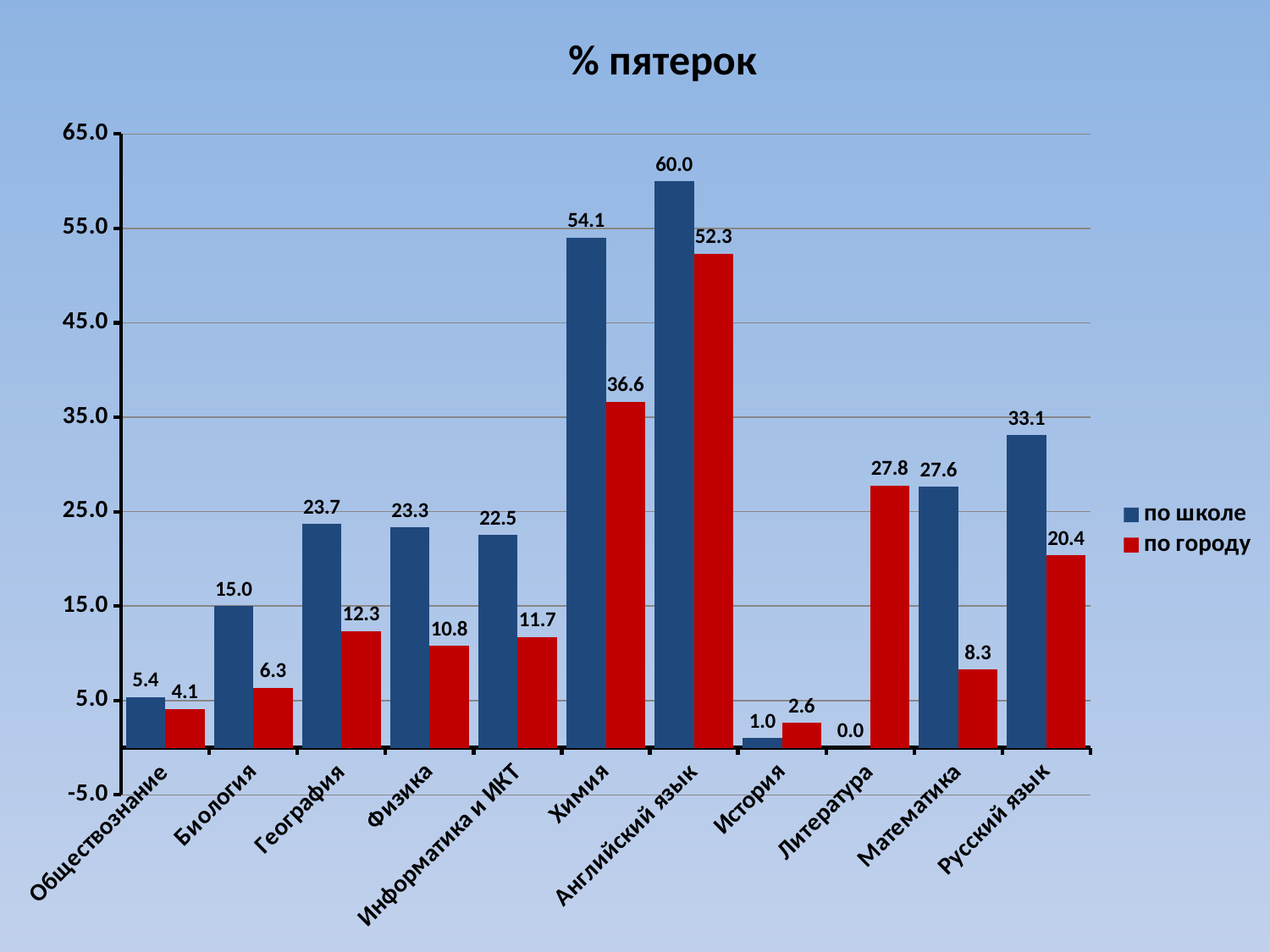
Which category has the lowest value for "по школе"? Литература What is the value for "по городу" for Математика? 8.3 What is the value for "по школе" for Химия? 54.1 What is the value for "по городу" for Литература? 27.8 How many series does the legend list? 2 Which category has the lowest value for "по городу"? История How many categories are shown on the x axis? 11 Which is larger for История: the "по школе" value or the "по городу" value? по городу What is the title of the chart? % пятерок Which category has the highest value for "по школе"? Английский язык What is the difference between the "по школе" and "по городу" values for Химия? 17.5 What kind of chart is shown on the slide? bar chart